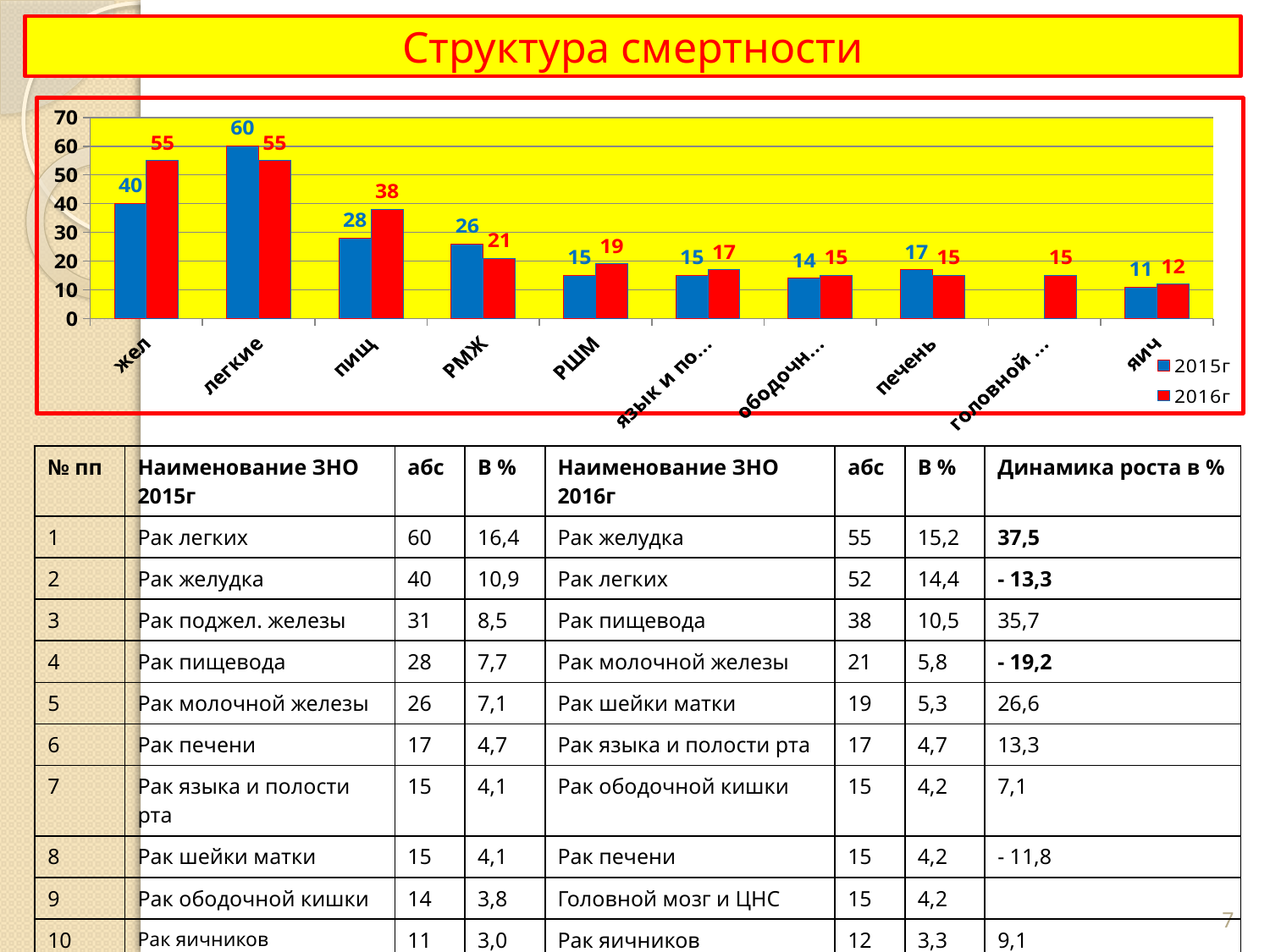
What colour are the bars for the 2016г series? red What is the difference between the 2015г and 2016г values for пищ? 10 What type of chart is shown on the slide? bar chart What is the value for легкие in the 2015г series? 60 How many series does the chart legend list? 2 Which category has the highest value in the 2015г series? легкие Which category has the lowest value in the 2016г series? яич How many categories are shown along the x axis of the chart? 10 For РМЖ, which series has the larger value, 2015г or 2016г? 2015г What is the value for пищ in the 2016г series? 38 What is the difference between the 2016г and 2015г values for жел? 15 What is the value for жел in the 2016г series? 55